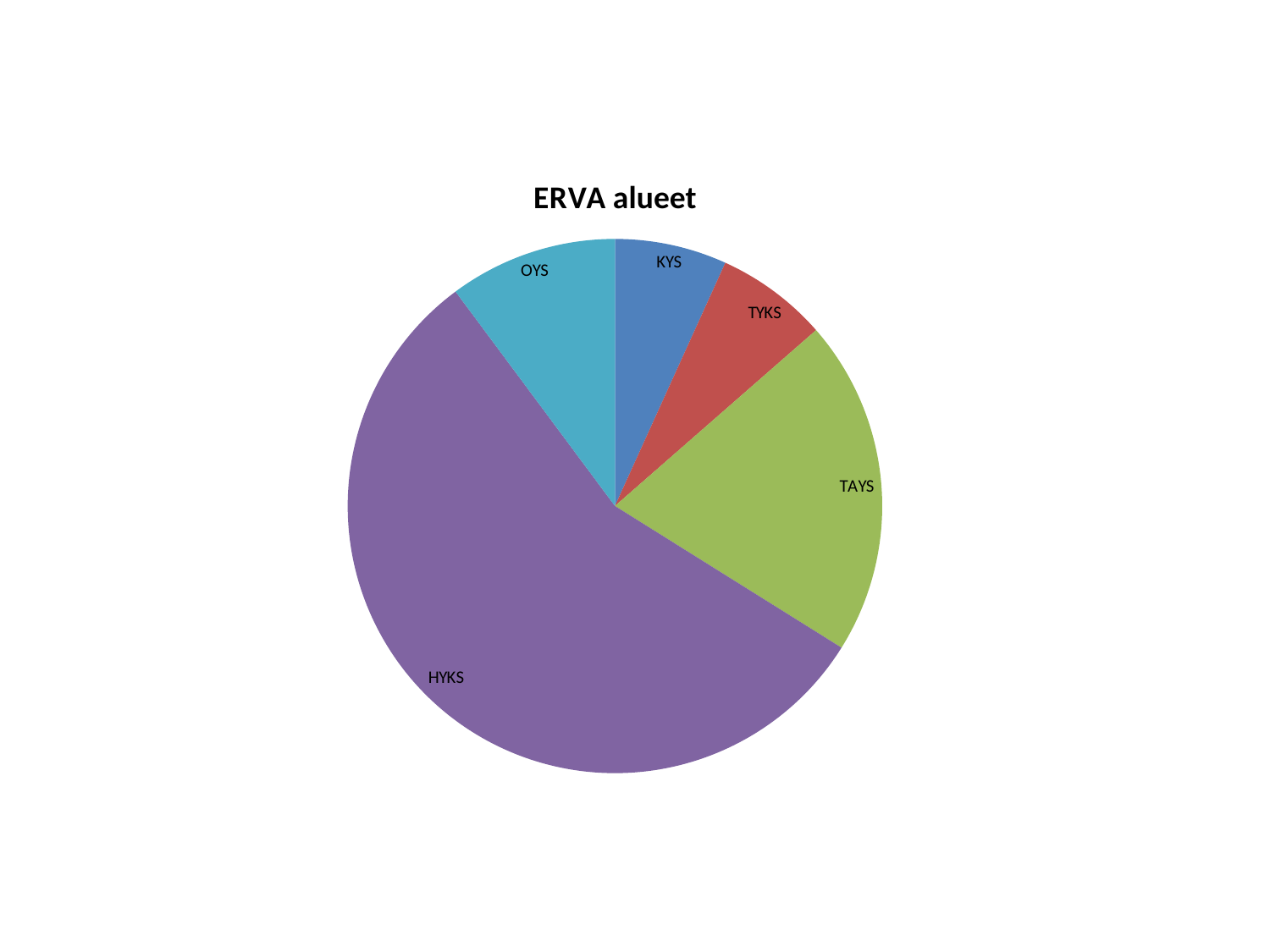
Which is larger, the slice for HYKS or the slice for TAYS? HYKS What kind of chart is shown on the slide? pie chart What is the title of the chart? ERVA alueet Which is larger, the slice for TAYS or the slice for OYS? TAYS Which category has the largest slice of the pie? HYKS Which is larger, the slice for TAYS or the slice for TYKS? TAYS Which category has the second largest slice of the pie? TAYS How many slices does the pie chart have? 5 Which category is shown in purple? HYKS Does the HYKS slice take up more or less than half of the pie? more